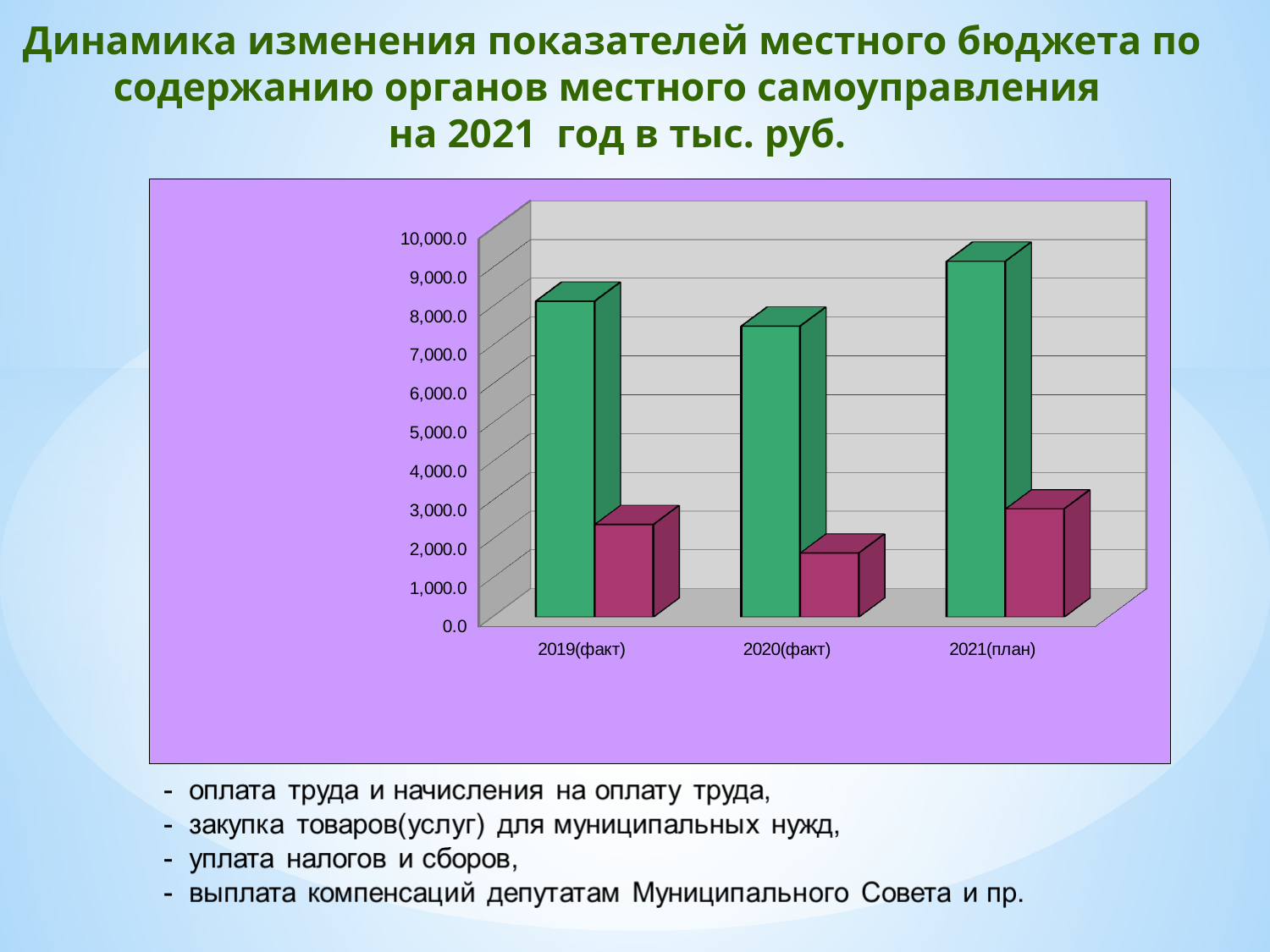
Which category has the shortest green bar? 2020(факт) What is the highest value shown on the vertical axis of the chart? 10,000.0 Which is larger, the green bar for 2019(факт) or the green bar for 2020(факт)? 2019(факт) Is the green bar for 2021(план) greater or less than 9,000.0? greater Is the magenta bar for 2019(факт) greater or less than 2,000.0? greater Which category has the shortest magenta bar? 2020(факт) What kind of chart is shown on the slide? bar chart Which category has the tallest magenta bar? 2021(план) How many categories are shown on the x axis of the chart? 3 Which category has the tallest green bar? 2021(план) Is the green bar for 2019(факт) greater or less than 7,000.0? greater